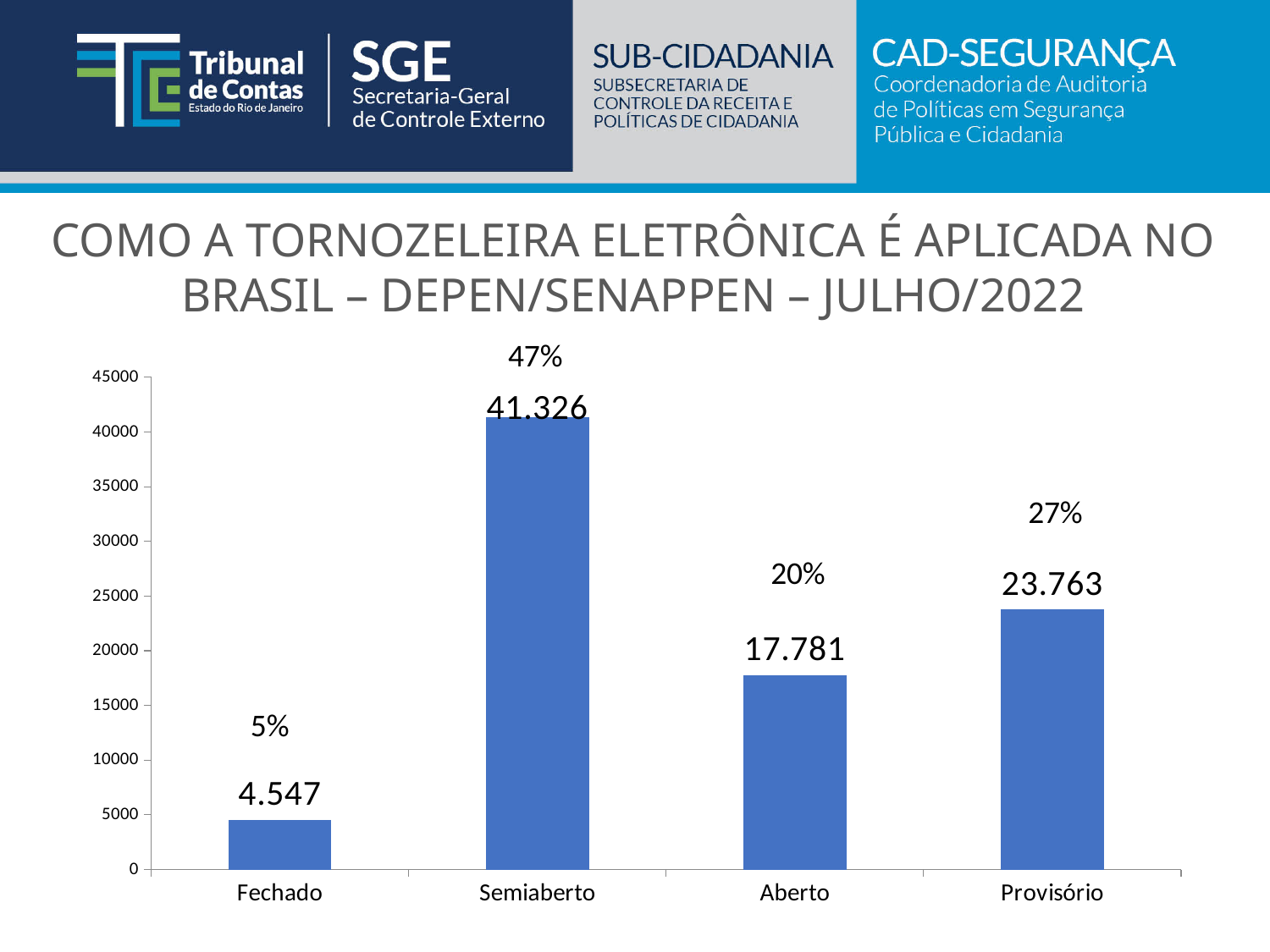
What is the difference between the values for Semiaberto and Fechado? 36.779 What kind of chart is shown on the slide? bar chart What percentage is shown above the Aberto bar? 20% Which category has the highest value? Semiaberto Is the value for Aberto greater or less than 20000? less What is the value for Fechado? 4.547 What percentage is shown above the Provisório bar? 27% What is the value for Semiaberto? 41.326 What is the difference between the values for Provisório and Aberto? 5.982 Which category has the lowest value? Fechado How many categories are shown on the x axis? 4 Which is larger, the value for Aberto or the value for Provisório? Provisório